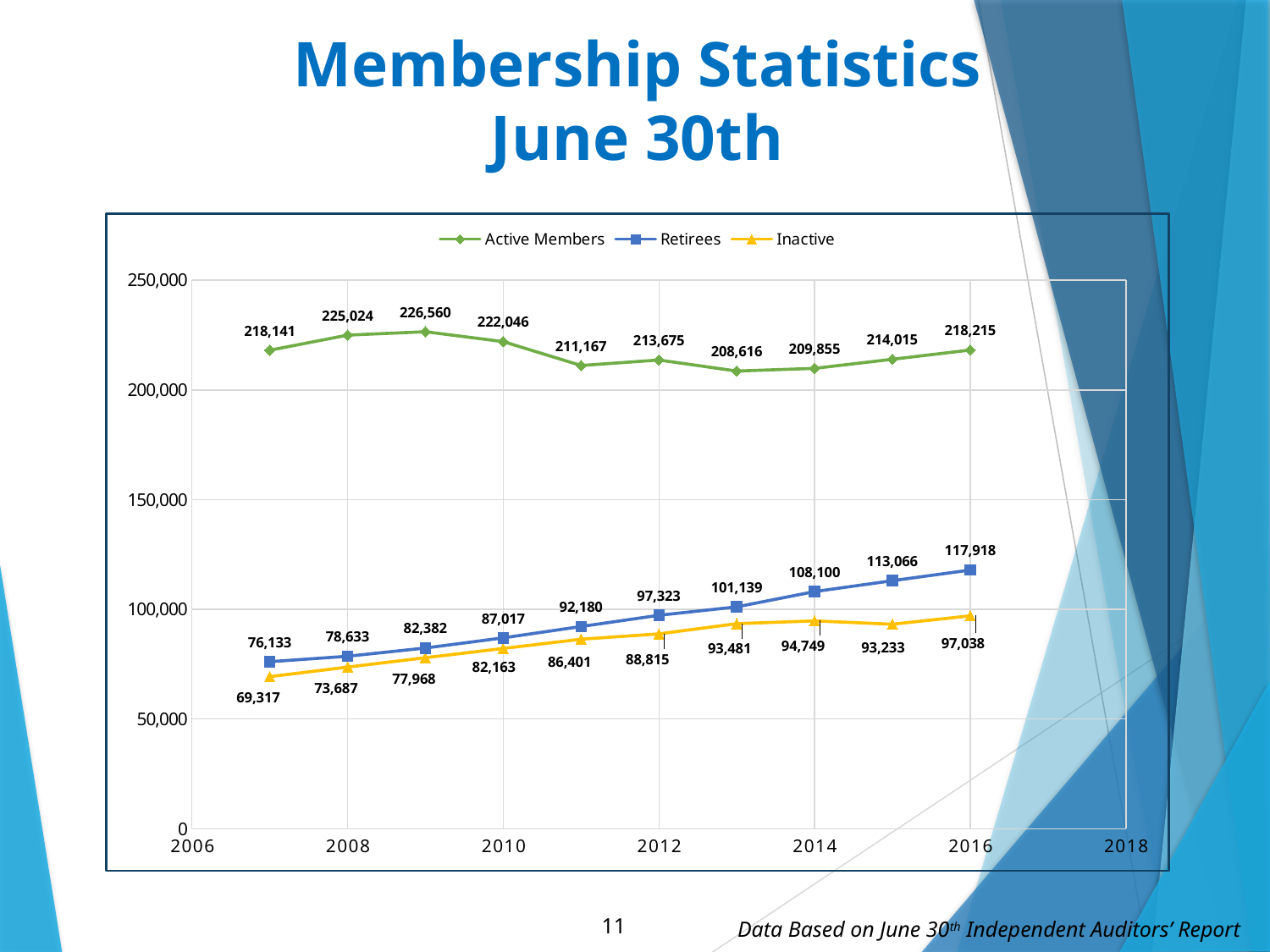
What kind of chart is shown on the slide? line chart In 2012, which is larger: Retirees or Inactive? Retirees How many series does the legend list? 3 Is the value for Active Members in 2014 greater or less than 200,000? greater What is the lowest value shown for Retirees? 76,133 What is the value for Inactive in 2014? 94,749 What is the difference between the Retirees value in 2016 and in 2008? 39,285 What is the highest value shown for Active Members? 226,560 What is the value for Active Members in 2016? 218,215 How many data points are plotted for the Retirees series? 10 What is the value for Retirees in 2010? 87,017 What is the difference between Active Members and Retirees in 2016? 100,297